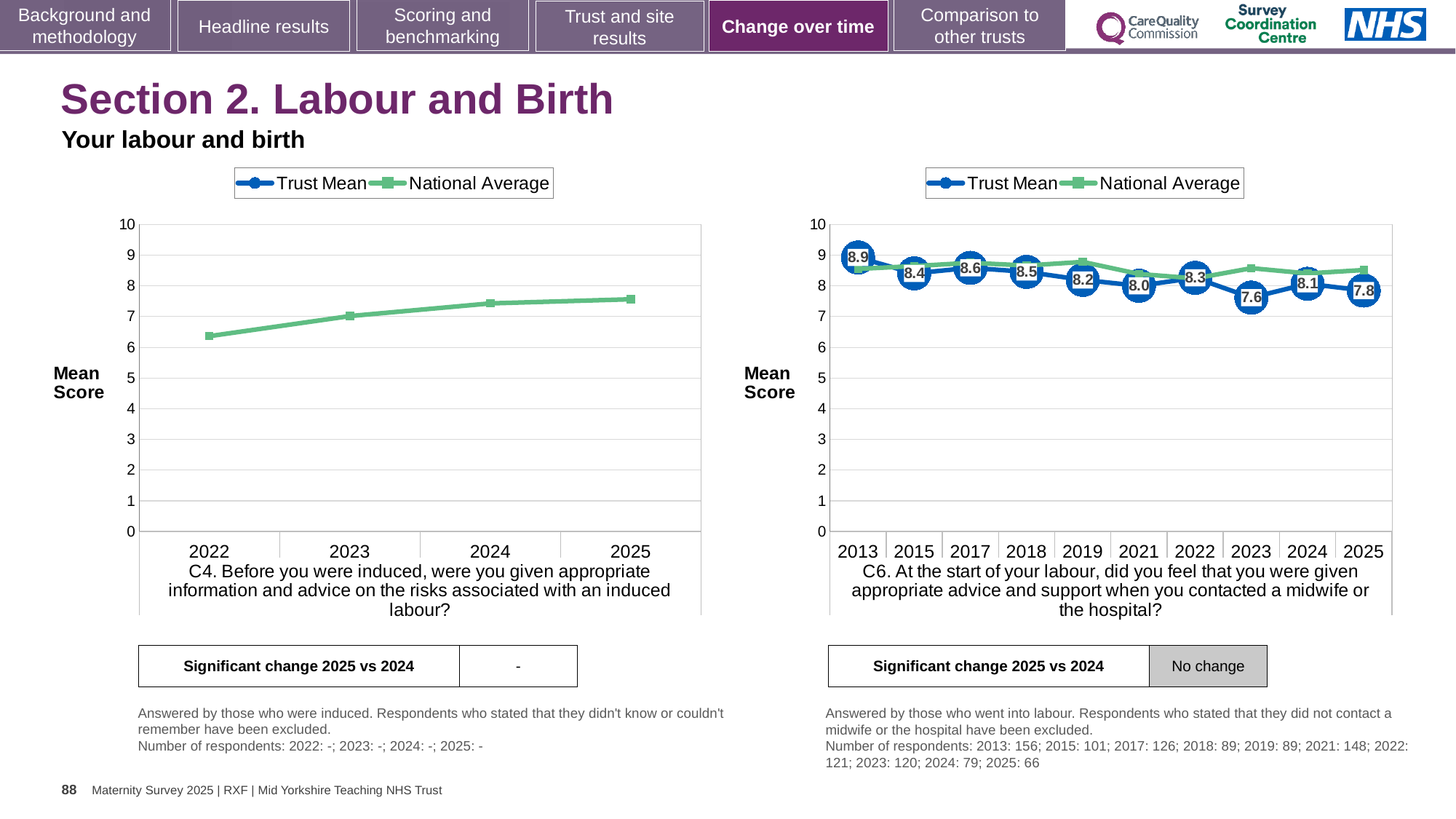
In the right chart (C6), which year has the larger Trust Mean score, 2024 or 2025? 2024 In the right chart (C6), which year has the highest Trust Mean score? 2013 What kind of chart is the right chart (C6)? Line chart In the right chart (C6), what is the difference between the Trust Mean scores for 2013 and 2025? 1.1 In the right chart (C6), what is the Trust Mean score for 2013? 8.9 In the right chart (C6), which year has the lowest Trust Mean score? 2023 How many series does the legend of the left chart (C4) list? 2 How many years are shown on the x axis of the left chart (C4)? 4 How many years are shown on the x axis of the right chart (C6)? 10 In the right chart (C6), what is the Trust Mean score for 2023? 7.6 In the left chart (C4), does the National Average rise or fall from 2022 to 2025? Rises In the left chart (C4), is the National Average value for 2022 greater or less than 7? less